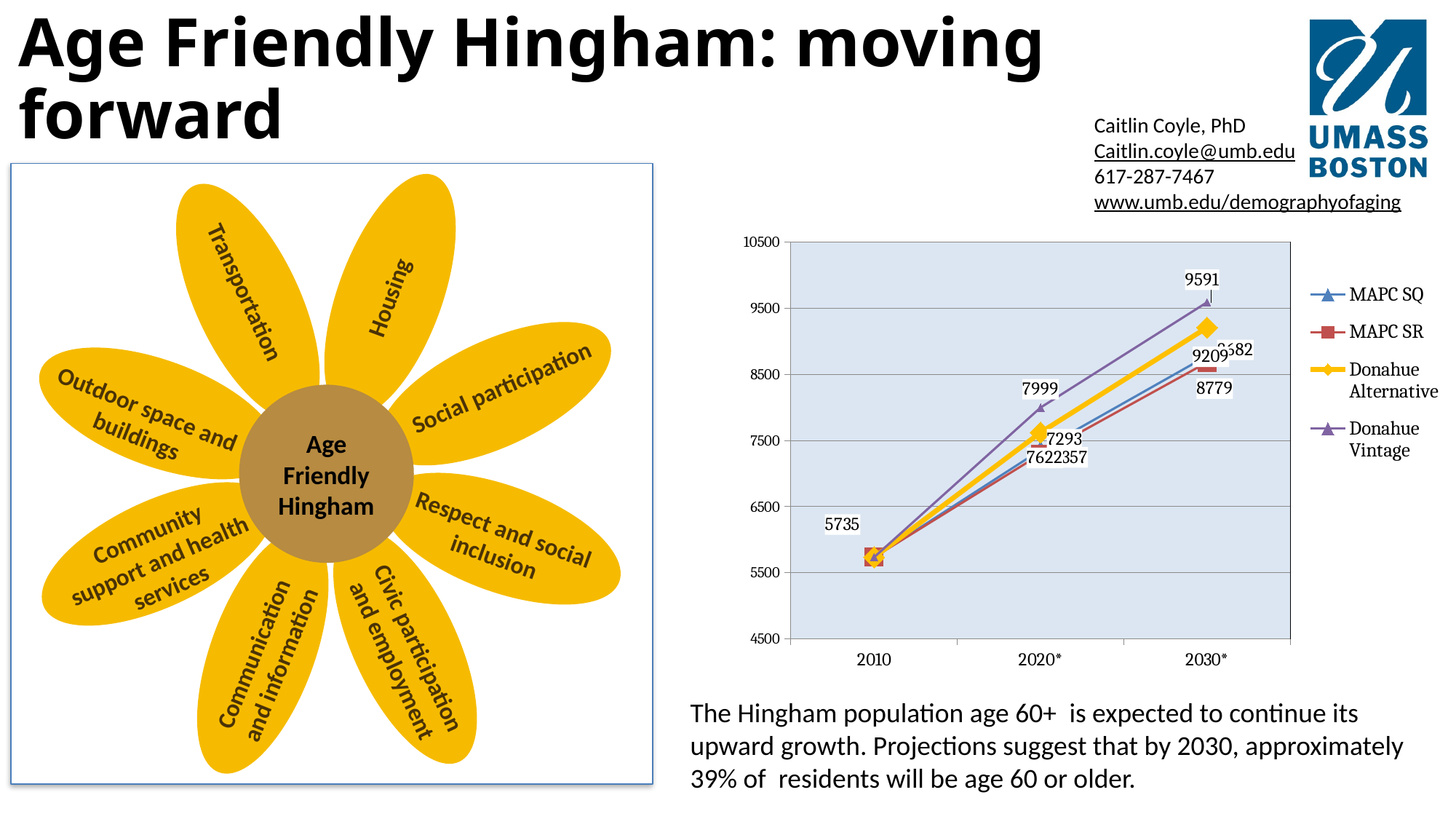
Which series in the line chart is drawn with a thick yellow line? Donahue Alternative In the line chart, is the value for Donahue Alternative in 2030* greater or less than 9000? greater In the line chart, how much does the Donahue Vintage value increase from 2010 to 2030*? 3856 In the line chart, what is the value shown for 2010? 5735 In the line chart, what is the value for Donahue Vintage in 2030*? 9591 In the line chart, what is the value for Donahue Vintage in 2020*? 7999 What kind of chart is shown on the right side of the slide? line chart How many series does the legend of the line chart list? 4 How many years are shown on the x axis of the line chart? 3 In the line chart, how much does the Donahue Vintage value increase from 2020* to 2030*? 1592 In the line chart, do the values rise or fall from 2010 to 2030*? rise In the line chart, which series has the highest value in 2030*? Donahue Vintage